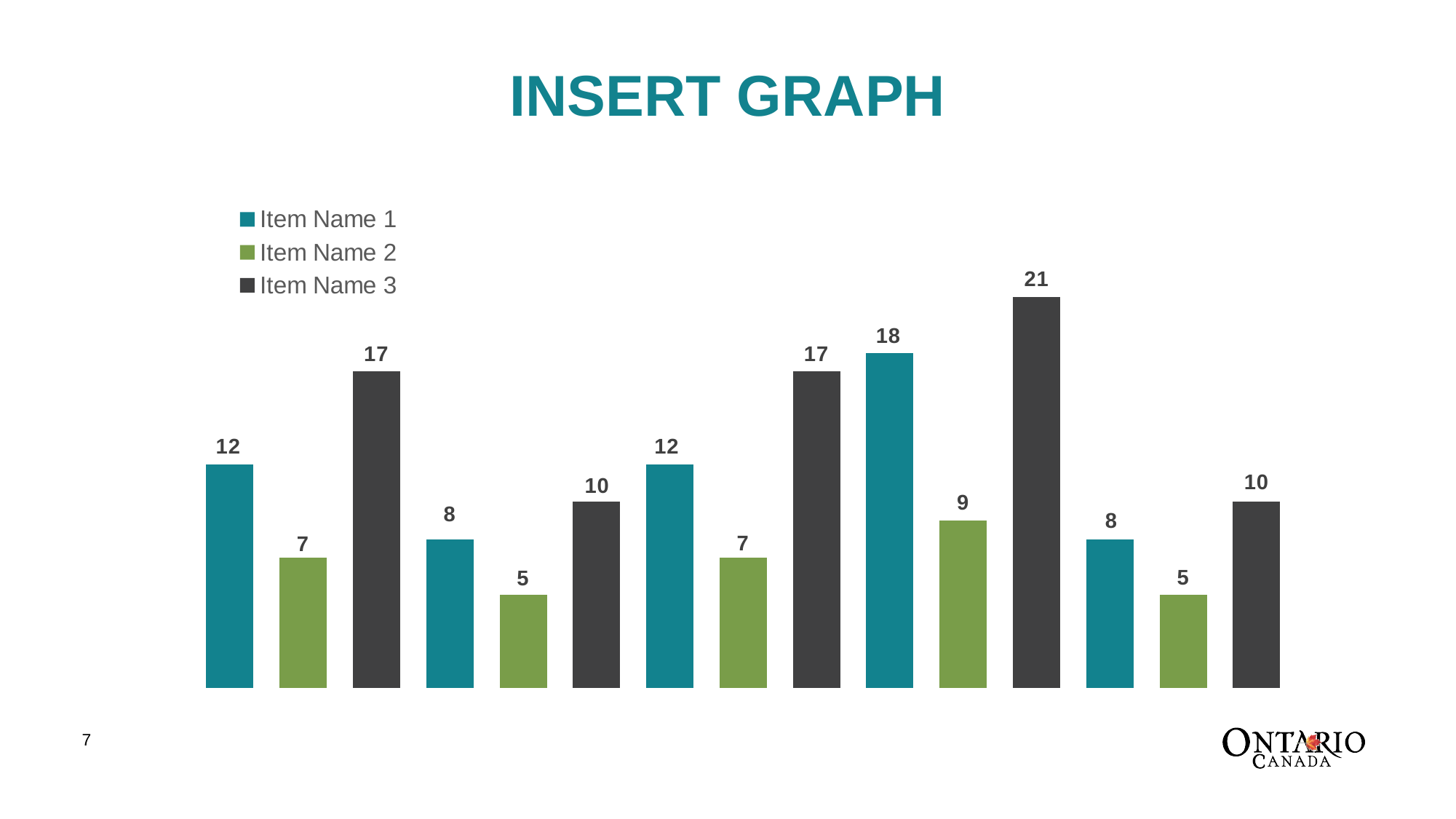
What is the value of the Item Name 3 bar in the fourth group of bars? 21 What is the value of the Item Name 1 bar in the first group of bars? 12 What is the difference between the Item Name 3 bar and the Item Name 1 bar in the fourth group of bars? 3 How many groups of bars are plotted in the chart? 5 What is the value of the Item Name 2 bar in the second group of bars? 5 What is the difference between the Item Name 3 bar in the first group and the Item Name 3 bar in the second group? 7 What kind of chart is shown on the slide? bar chart Which series has the tallest bar in the chart? Item Name 3 What is the lowest value shown on any bar in the chart? 5 What colour are the Item Name 2 bars? green In the first group of bars, which is larger: the Item Name 1 bar or the Item Name 2 bar? Item Name 1 How many series does the legend list? 3